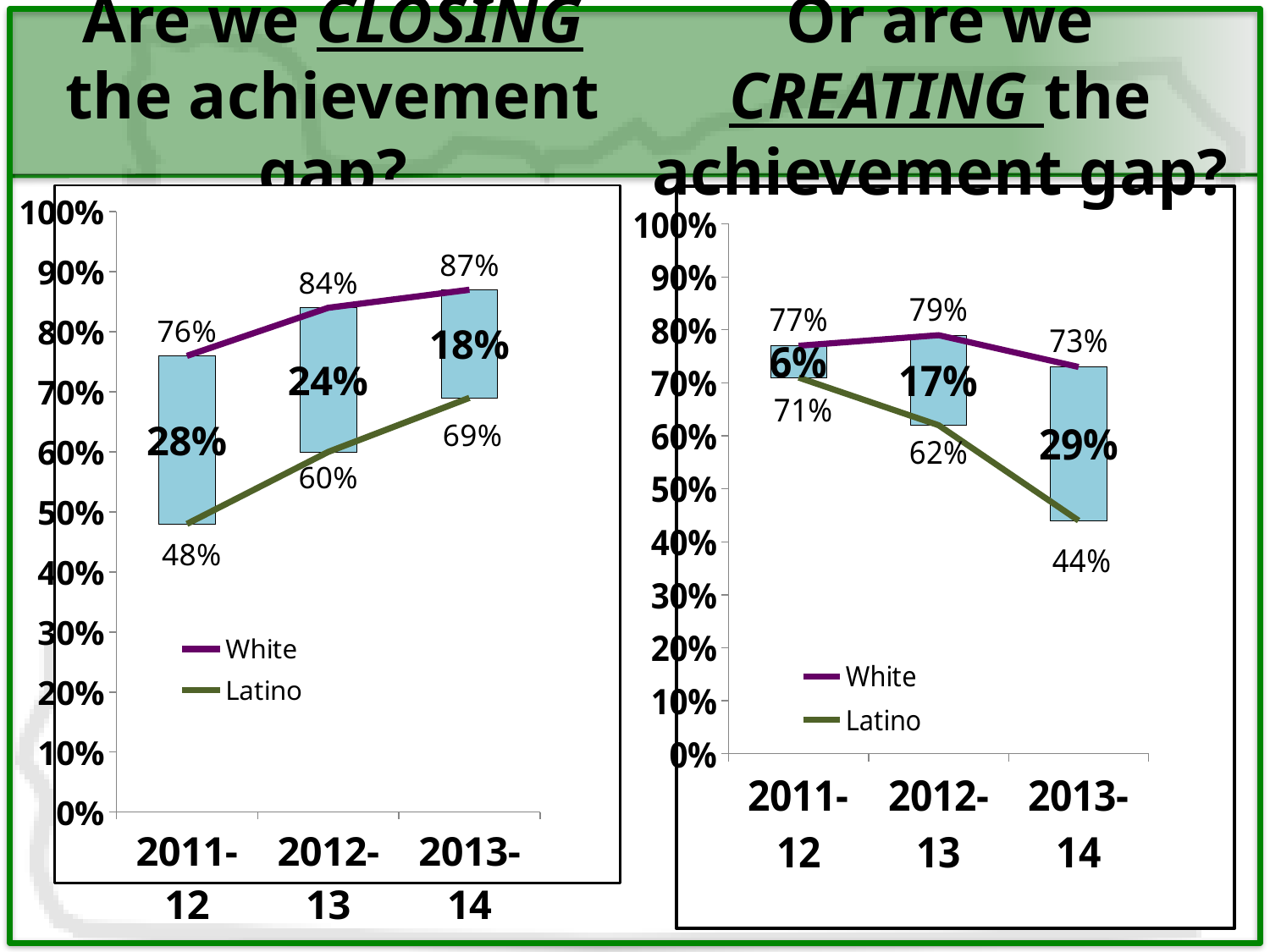
In the right chart ("Or are we CREATING the achievement gap?"), what is the value for White in 2012-13? 79% In the left chart ("Are we CLOSING the achievement gap?"), what is the value for White in 2013-14? 87% How many years are shown on the x axis of the right chart ("Or are we CREATING the achievement gap?")? 3 How many series does the legend of the left chart ("Are we CLOSING the achievement gap?") list? 2 In the left chart ("Are we CLOSING the achievement gap?"), does the Latino value rise or fall from 2011-12 to 2013-14? rise In the left chart ("Are we CLOSING the achievement gap?"), in which year is the Latino value lowest? 2011-12 In the right chart ("Or are we CREATING the achievement gap?"), in which year is the White value highest? 2012-13 In the left chart ("Are we CLOSING the achievement gap?"), what is the value for Latino in 2011-12? 48% In the left chart ("Are we CLOSING the achievement gap?"), what is the gap between White and Latino in 2012-13? 24% In the right chart ("Or are we CREATING the achievement gap?"), what is the value for Latino in 2013-14? 44% In the right chart ("Or are we CREATING the achievement gap?"), what is the gap between White and Latino in 2011-12? 6% In the right chart ("Or are we CREATING the achievement gap?"), does the Latino value rise or fall from 2011-12 to 2013-14? fall